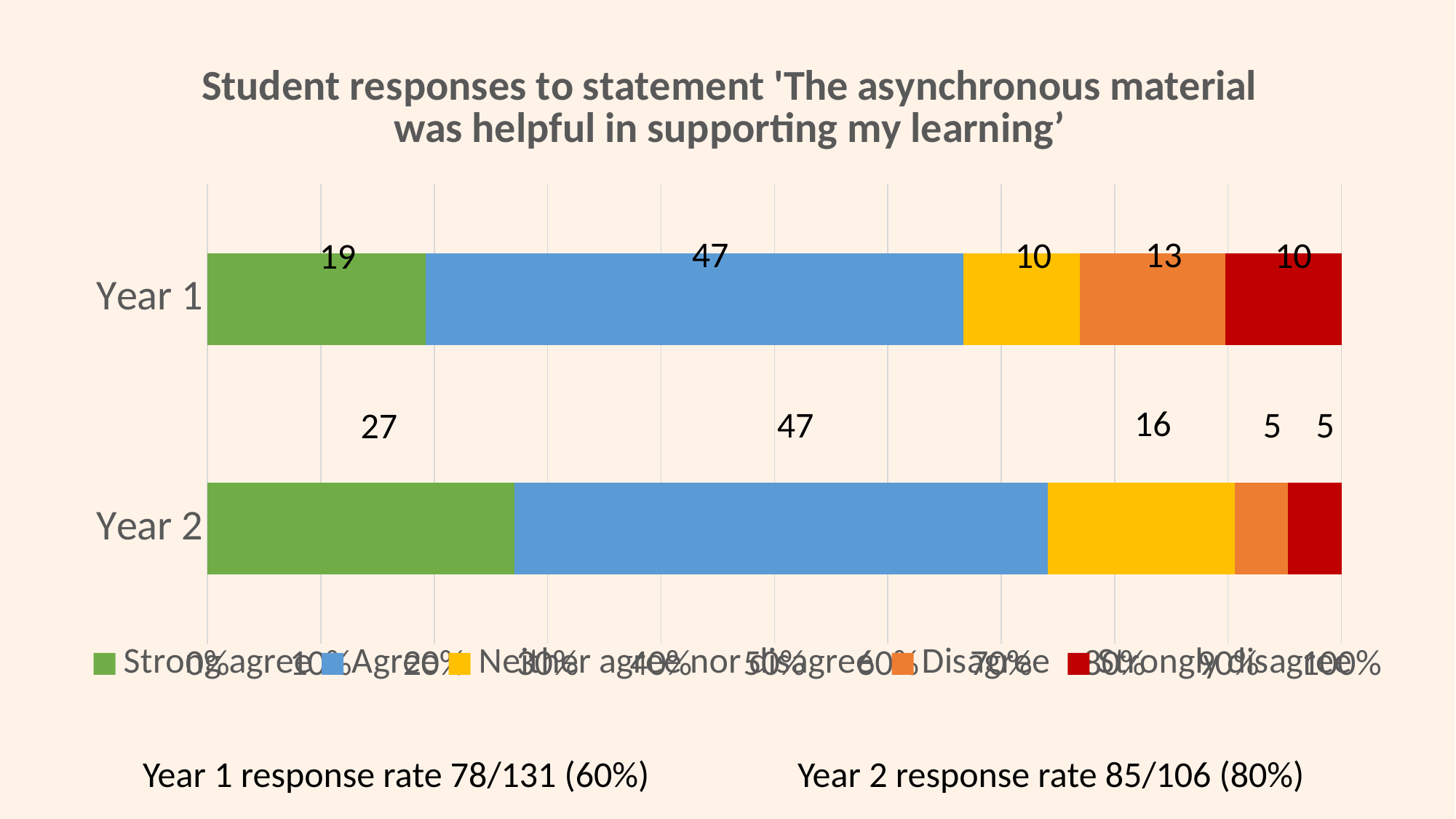
How many categories (years) are plotted on the chart? 2 Which year has the larger Disagree (orange) value, Year 1 or Year 2? Year 1 How many series does the legend list? 5 What is the Year 1 response rate stated below the chart? 78/131 (60%) What is the value for Neither agree nor disagree (yellow) in Year 2? 16 What is the total of the Year 2 stacked bar? 100 What is the difference between the Strongly agree (green) values for Year 2 and Year 1? 8 What is the value for Disagree (orange) in Year 1? 13 What is the value for Strongly agree (green) in Year 1? 19 What is the value for Agree (blue) in Year 2? 47 What kind of chart is shown on the slide? Stacked bar chart Which series has the highest value in the Year 1 bar? Agree